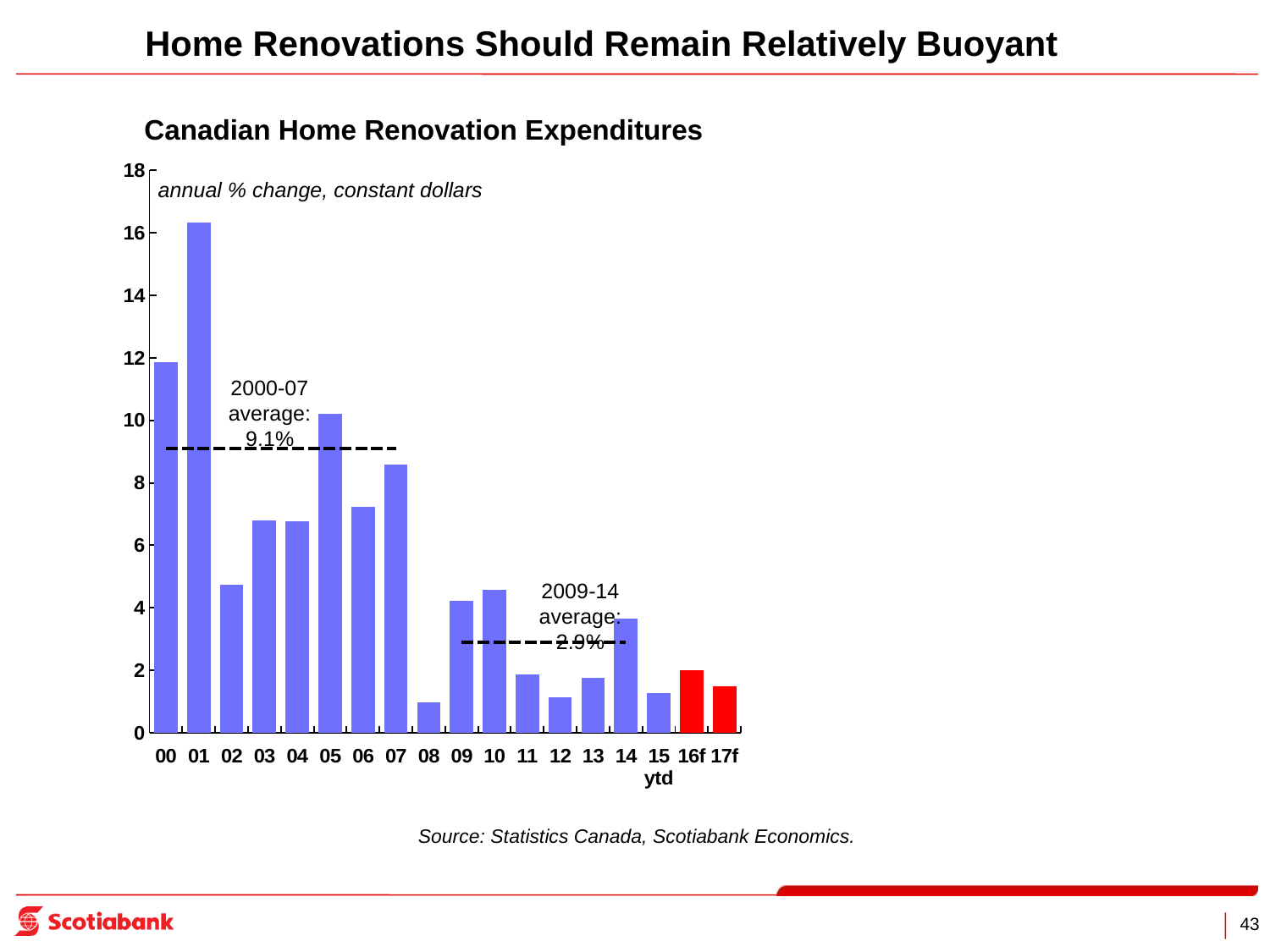
What kind of chart is shown on the slide? bar chart Which is larger, the value for 00 or the value for 05? 00 What is the 2009-14 average annual % change shown on the chart? 2.9% What is the value for 16f? 2 What is the 2000-07 average annual % change shown on the chart? 9.1% Is the value for 00 greater or less than 10? greater Do the values rise or fall from 05 to 08? fall Is the value for 07 greater or less than 10? less Which year has the highest annual % change in home renovation expenditures? 01 Is the value for 15 ytd greater or less than 2? less How many bars (years) are plotted in the chart? 18